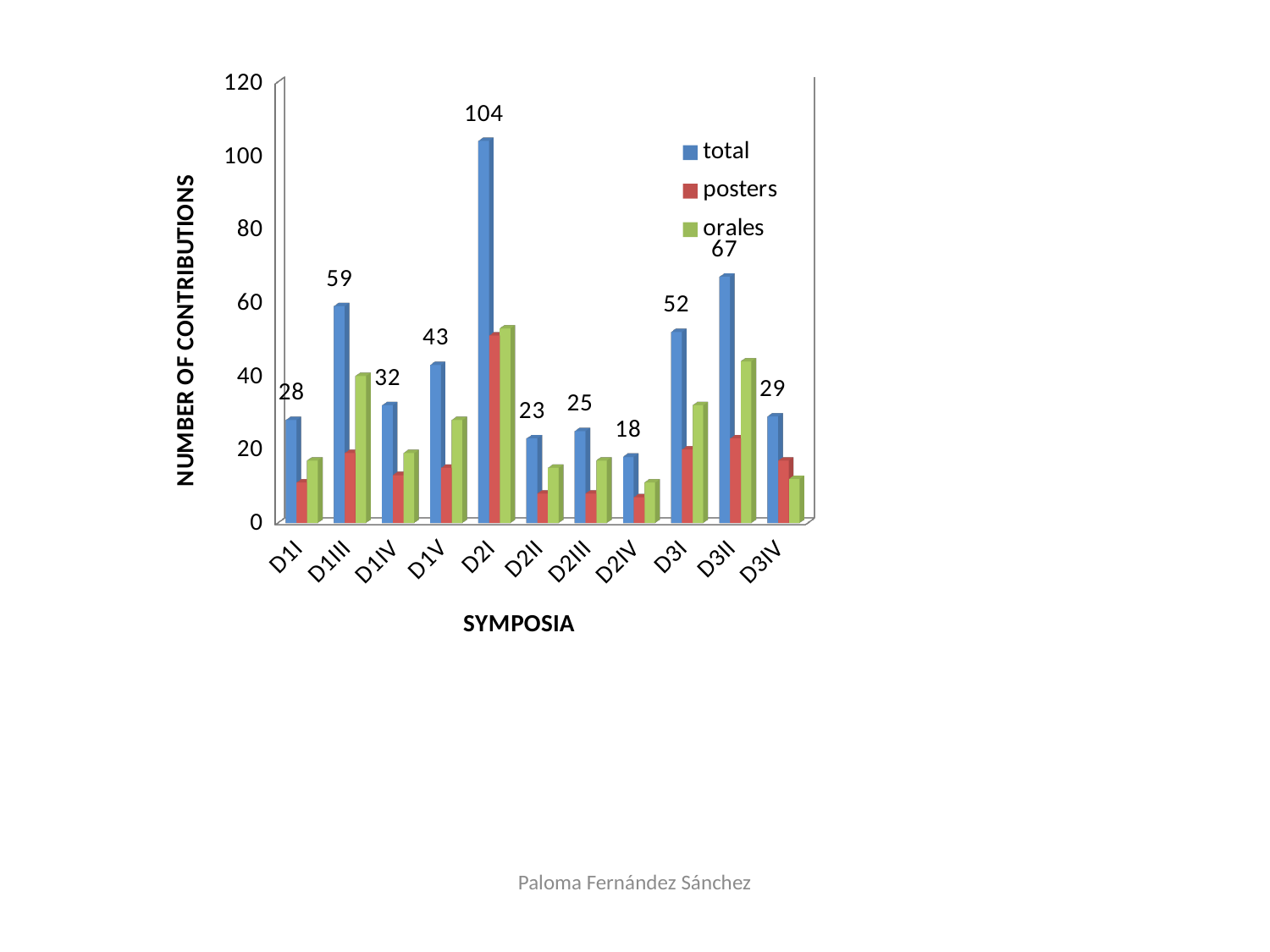
Which symposium has a larger total number of contributions, D1III or D3I? D1III Is the value for orales at D2I greater or less than 40? greater What kind of chart is shown on the slide? Bar chart What is the total number of contributions for symposium D3II? 67 Which symposium has the lowest total number of contributions? D2IV Is the value for posters at D1I greater or less than 20? less How many series does the legend list? 3 Which symposium has the highest total number of contributions? D2I How many symposia are shown on the x axis? 11 What is the total number of contributions for symposium D2IV? 18 What is the total number of contributions for symposium D2I? 104 What is the difference between the total contributions for D2I and D3II? 37